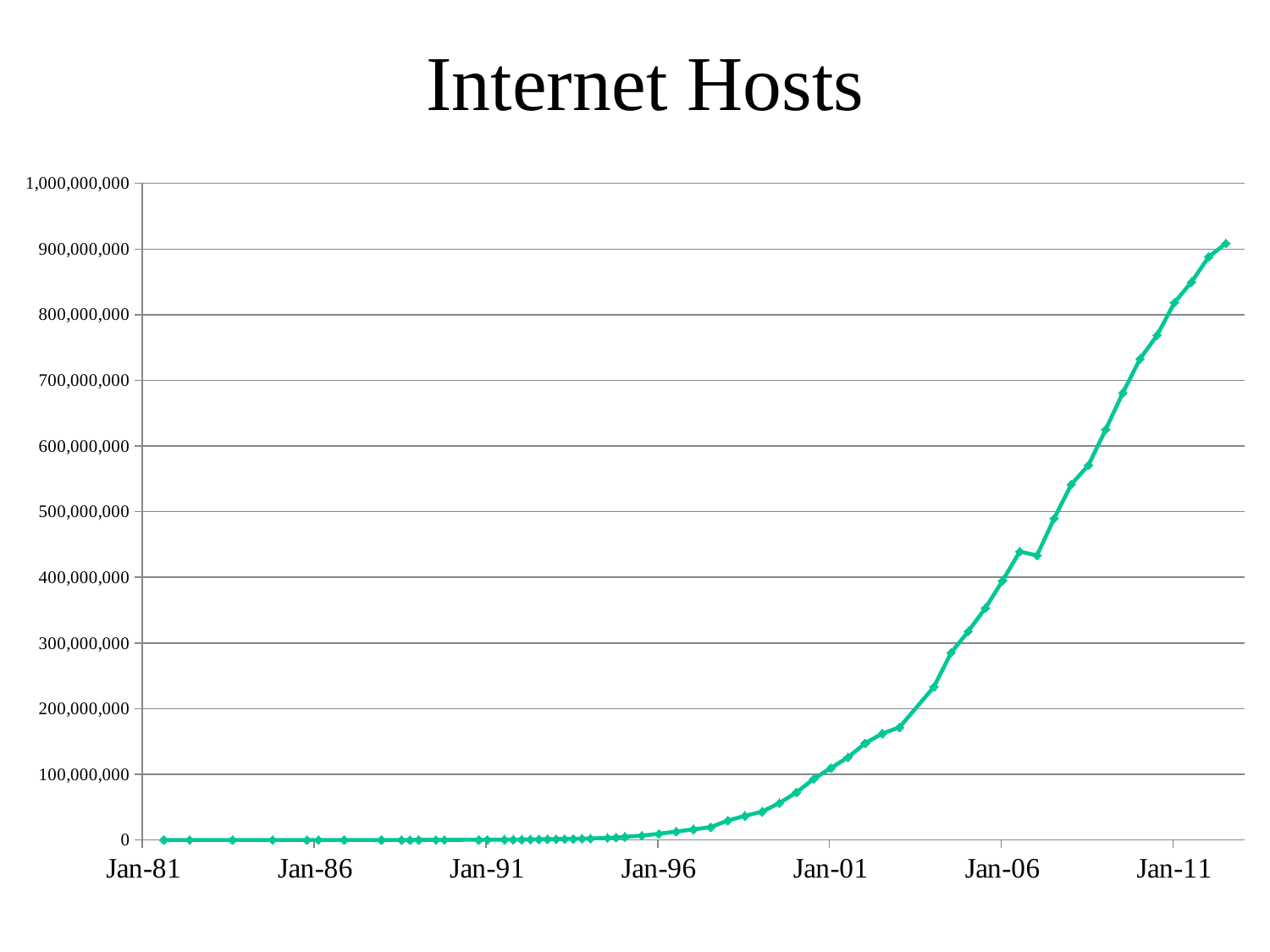
Is the value at Jan-91 greater or less than 100,000,000? less Is the value at Jan-06 greater or less than 300,000,000? greater What is the title of the chart? Internet Hosts Do the values generally rise or fall from Jan-81 to Jan-11? rise What kind of chart is shown on the slide? line chart Which is larger, the value at Jan-06 or the value at Jan-01? Jan-06 Is the value at Jan-01 greater or less than 200,000,000? less Which labelled x-axis date has the highest value? Jan-11 Which is larger, the value at Jan-96 or the value at Jan-11? Jan-11